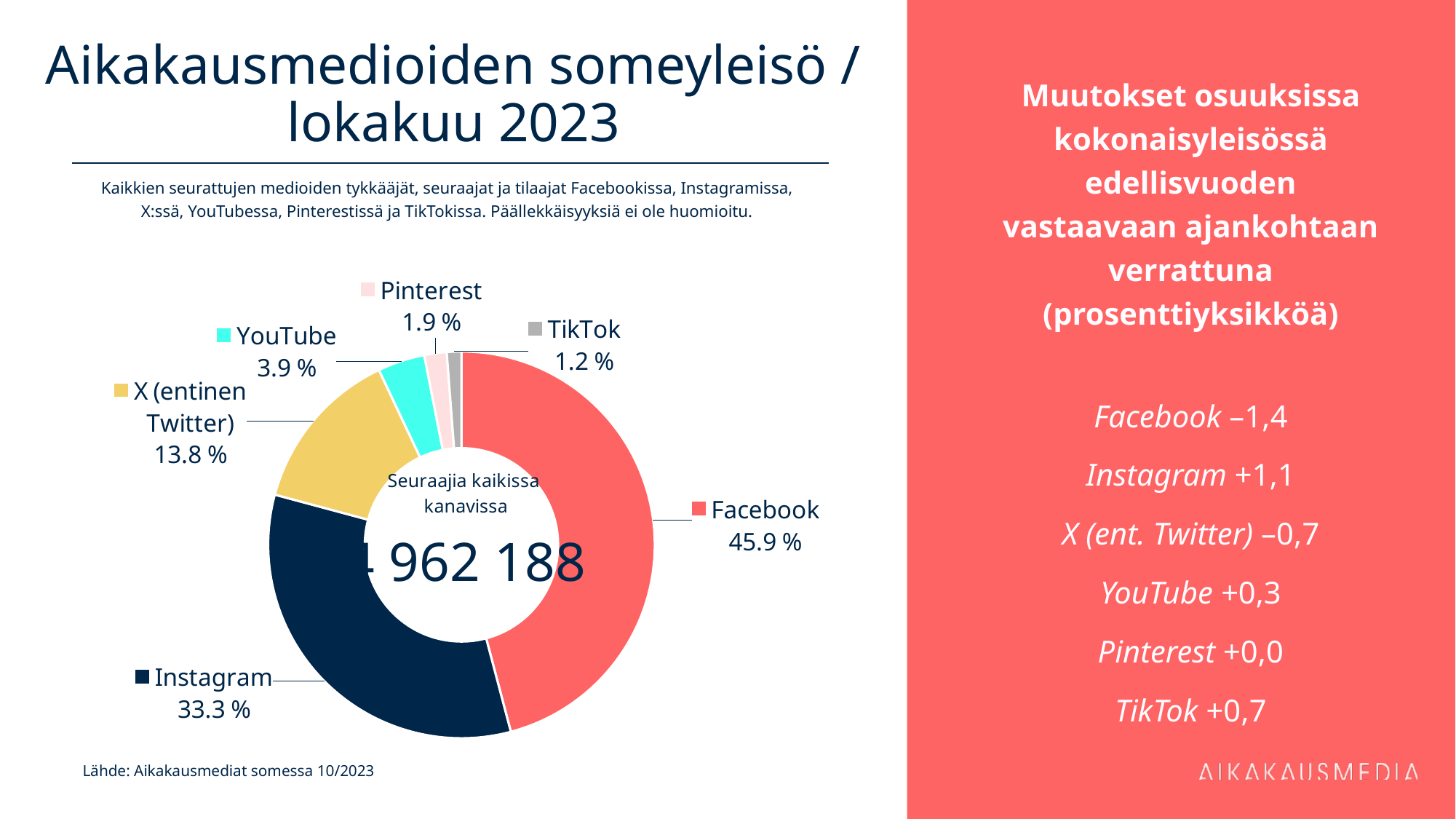
Which channel has the smallest share in the chart? TikTok What colour is the Instagram slice in the chart? Dark navy blue What is the value shown for YouTube in the chart? 3.9 % What is the difference in percentage points between Facebook's and Instagram's shares? 12.6 Which has a larger share, Pinterest or YouTube? YouTube What type of chart is shown on the slide? Doughnut (pie) chart What share of the doughnut chart does Instagram hold? 33.3 % How many channels (slices) are shown in the chart? 6 What is the value shown for X (entinen Twitter) in the chart? 13.8 % What is the value shown for TikTok in the chart? 1.2 % Which channel has the largest share in the chart? Facebook What share of the doughnut chart does Facebook hold? 45.9 %